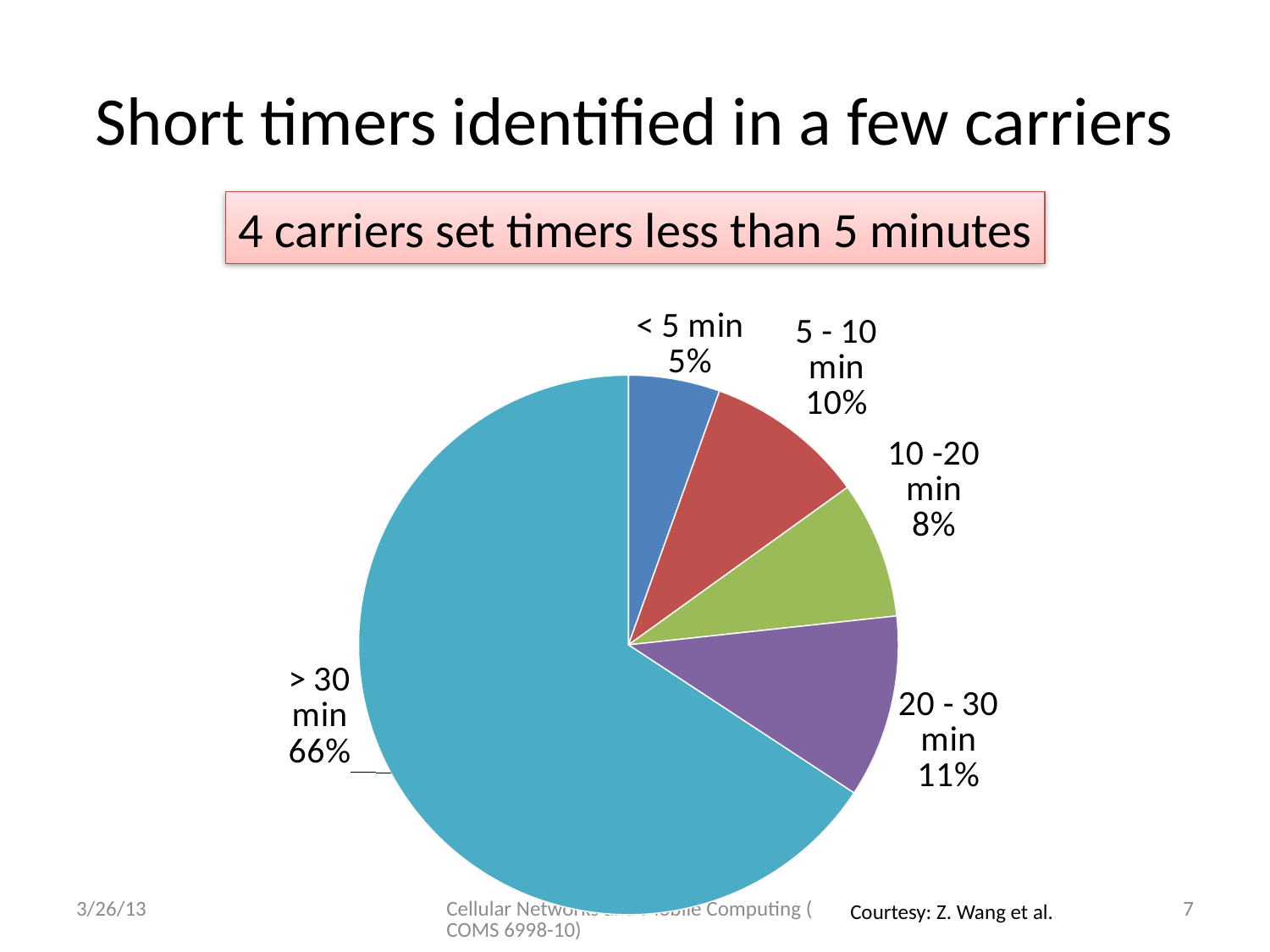
Which slice is larger, "5 - 10 min" or "10 -20 min"? 5 - 10 min What kind of chart is shown on the slide? pie chart What share of the pie does the "> 30 min" slice represent? 66% What share of the pie does the "10 -20 min" slice represent? 8% What is the difference in percentage points between the "> 30 min" slice and the "20 - 30 min" slice? 55 Which slice of the pie is the largest? > 30 min What share of the pie does the "5 - 10 min" slice represent? 10% How many slices does the pie chart have? 5 Which slice of the pie is the smallest? < 5 min What colour is the "> 30 min" slice? teal/light blue